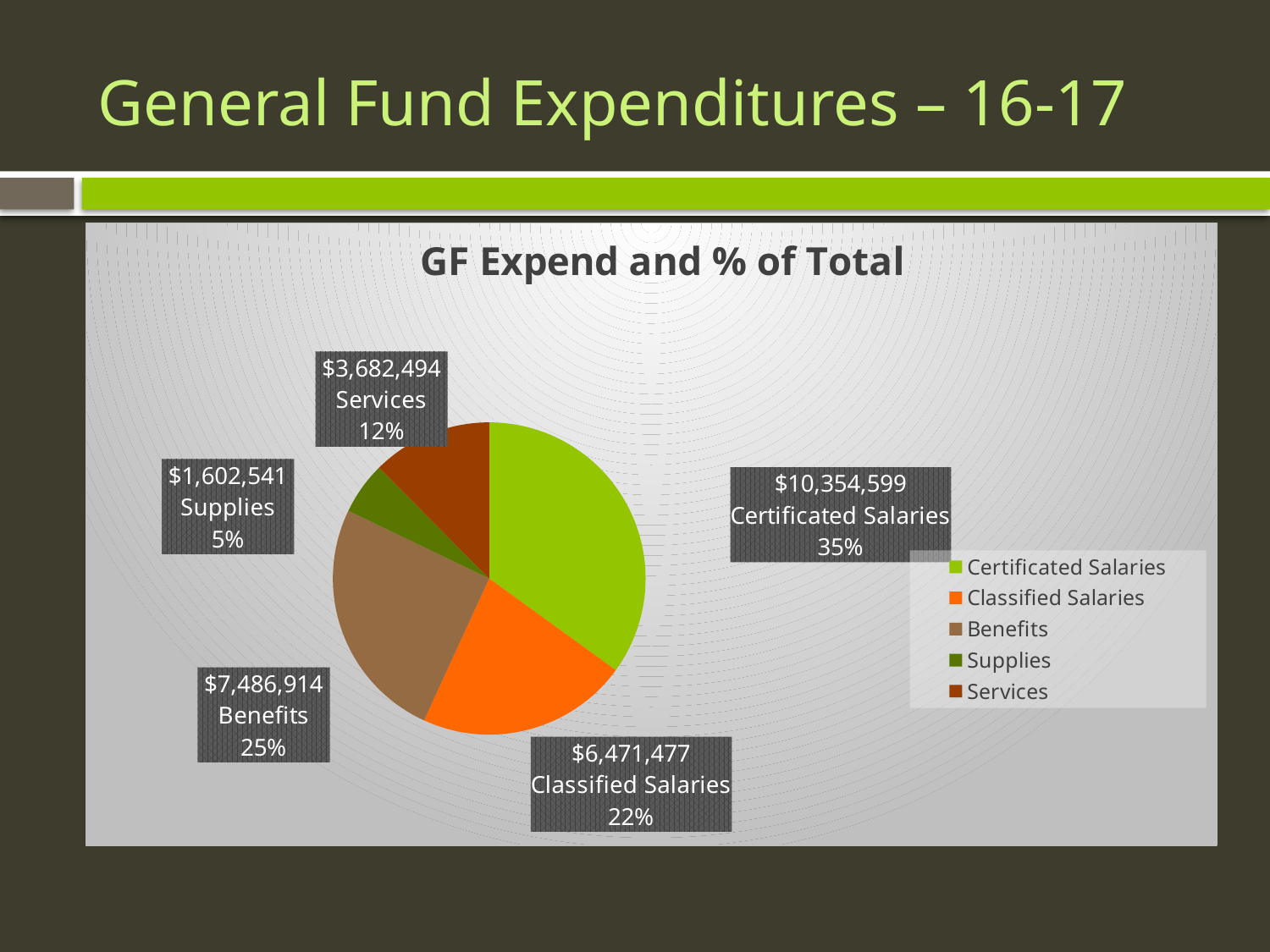
What is the title of the chart? GF Expend and % of Total What is the value for Certificated Salaries? $10,354,599 What percentage of the total is Classified Salaries? 22% How many categories does the legend list? 5 Which category has the smallest share of the pie? Supplies What is the value for Benefits? $7,486,914 What type of chart is shown on the slide? pie chart What is the difference between Certificated Salaries and Classified Salaries? $3,883,122 Which category has the largest share of the pie? Certificated Salaries What is the value for Supplies? $1,602,541 Which is larger, Benefits or Classified Salaries? Benefits What percentage of the total is Services? 12%